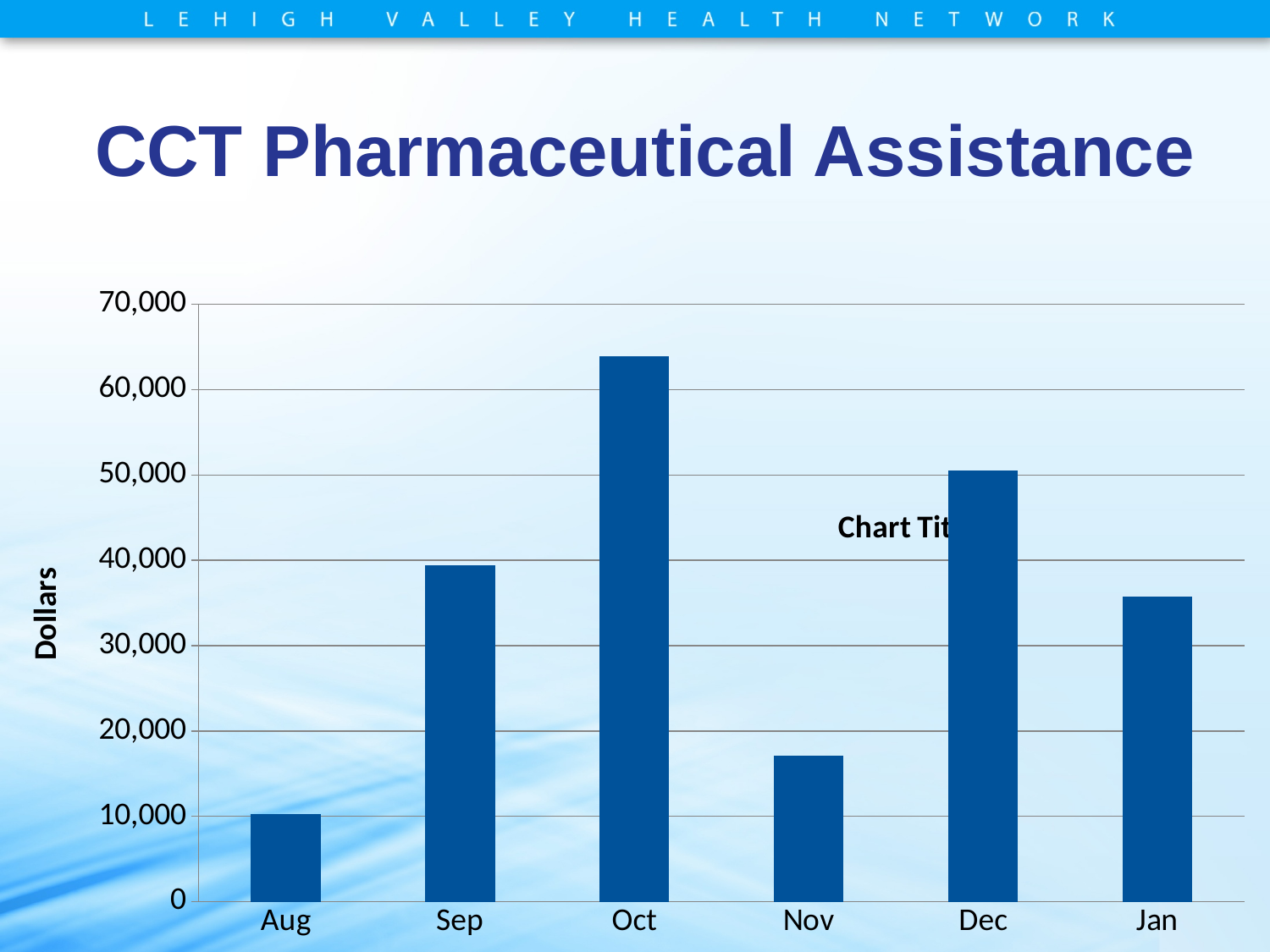
What kind of chart is shown on the slide? bar chart Is the value for Jan greater or less than 40,000? less Which month has the lowest value in the chart? Aug What is the label on the vertical axis of the chart? Dollars Which is larger, the value for Oct or the value for Dec? Oct Which month has the highest value in the chart? Oct Is the value for Dec greater or less than 40,000? greater Is the value for Nov greater or less than 20,000? less Does the value rise or fall from Oct to Nov? fall Which is larger, the value for Sep or the value for Nov? Sep How many months are shown on the x axis of the chart? 6